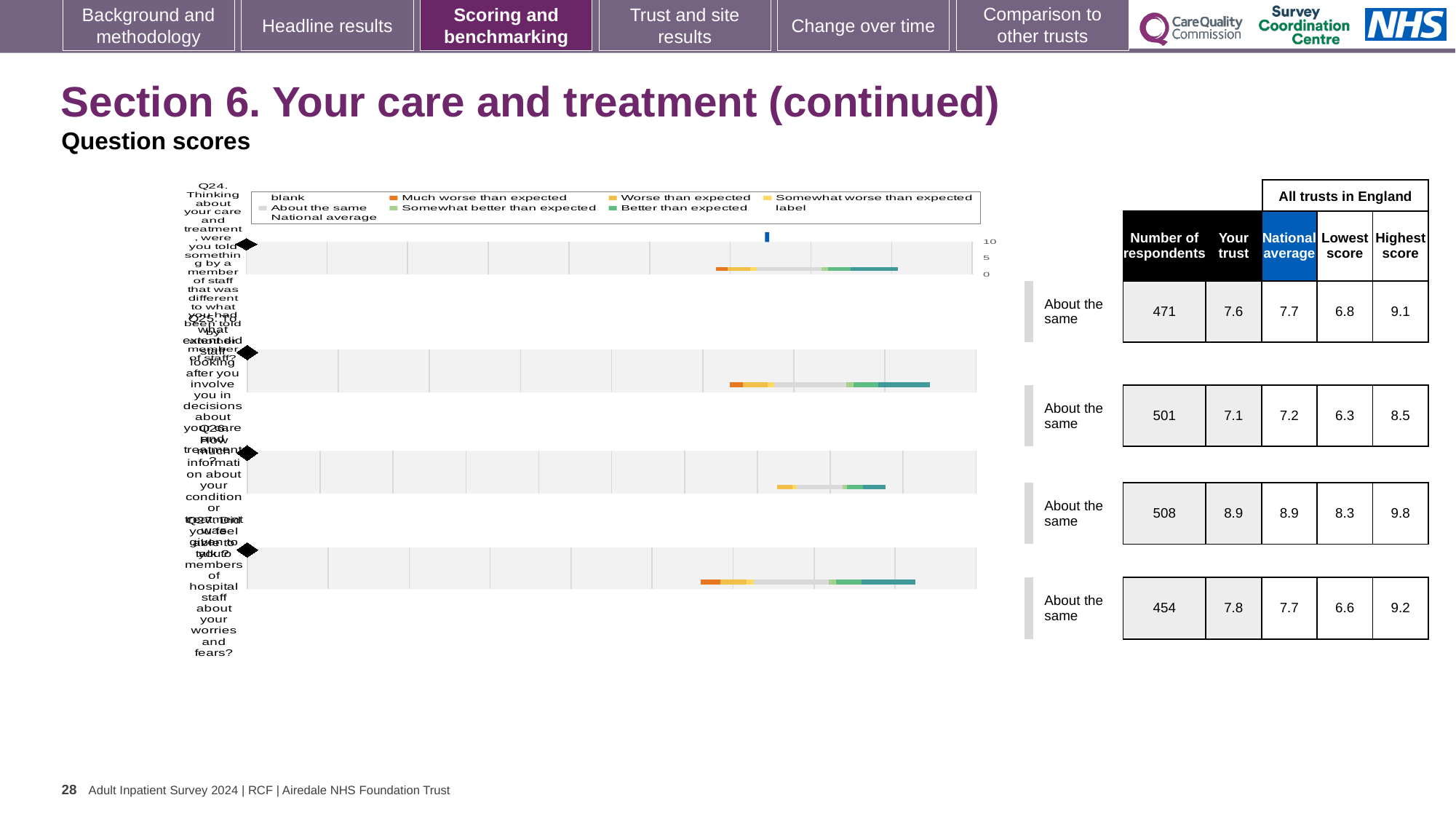
Which question has the lowest 'Your trust' score in the table? Q25 What kind of chart is used for the question scores on this slide? bar chart How many question charts (Q24 to Q27) are shown on the slide? 4 For the first chart (Q24), what is the difference between the highest score and the lowest score? 2.3 For the first chart (Q24), how many respondents are shown in the table? 471 In the legend, what colour represents 'Much worse than expected'? orange For the second chart (Q25), what is the lowest score among all trusts in England? 6.3 For the third chart (Q26), what is the national average score? 8.9 For the first chart (Q24), what is the 'Your trust' score shown in the table? 7.6 What benchmark category label is shown next to each of the four charts? About the same For the fourth chart (Q27), which is larger: the 'Your trust' score or the national average? Your trust Which question has the highest 'Your trust' score in the table? Q26